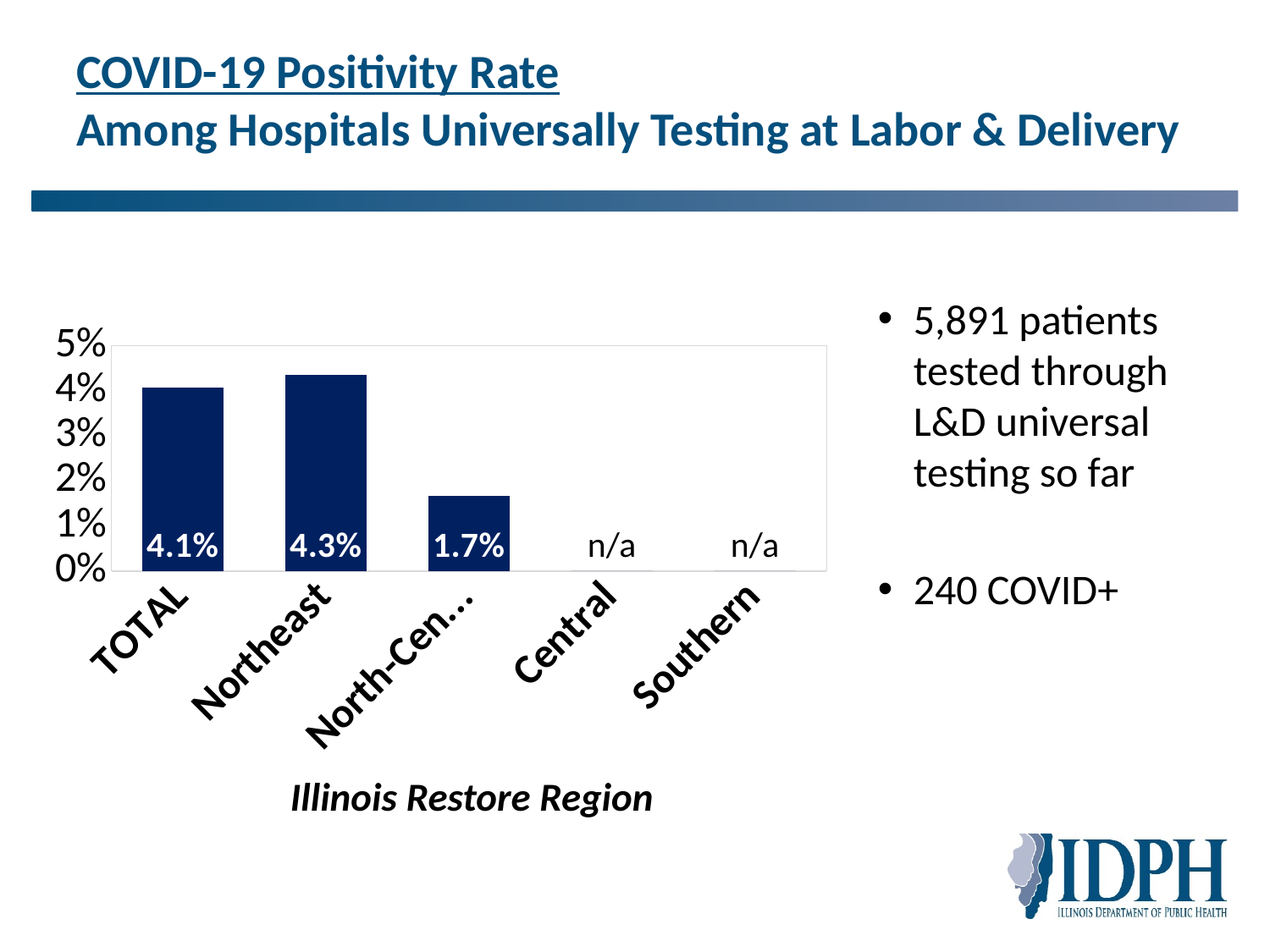
What is the COVID-19 positivity rate shown for TOTAL? 4.1% Is the value for TOTAL greater or less than 3%? greater Among the bars with a printed percentage, which category has the lowest value? North-Cen… What is shown for the Central region in the chart? n/a Which is larger, the TOTAL rate or the Northeast rate? Northeast What is the positivity rate shown for the Northeast region? 4.3% How much higher is the Northeast positivity rate than the TOTAL rate? 0.2% What is the title of the x axis of the chart? Illinois Restore Region How many categories are shown on the x axis of the chart? 5 What value is labelled on the third bar (North-Cen…)? 1.7% Which region has the highest positivity rate in the chart? Northeast What is the difference between the Northeast rate and the North-Cen… rate? 2.6%